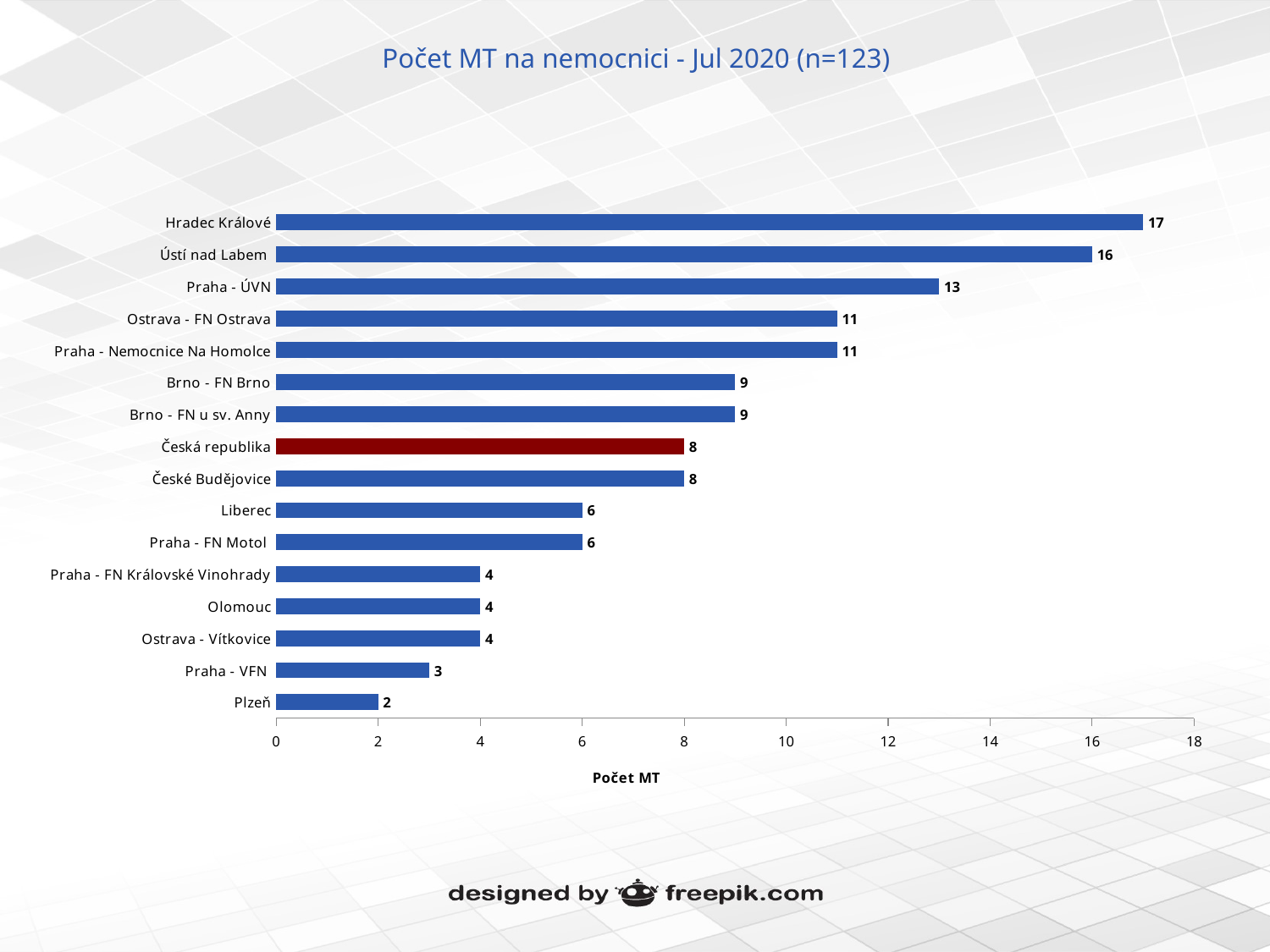
What is the difference between the values for Ústí nad Labem and Brno - FN Brno? 7 What is the title of the chart? Počet MT na nemocnici - Jul 2020 (n=123) Which is larger, the value for Ostrava - FN Ostrava or the value for Liberec? Ostrava - FN Ostrava What is the value for Praha - VFN? 3 Which category has the highest value? Hradec Králové Which category has the lowest value? Plzeň How many categories are shown in the chart? 16 What is the value for Hradec Králové? 17 What is the value for Česká republika? 8 Which category's bar is coloured dark red instead of blue? Česká republika What is the value for Praha - ÚVN? 13 What kind of chart is shown on the slide? Bar chart